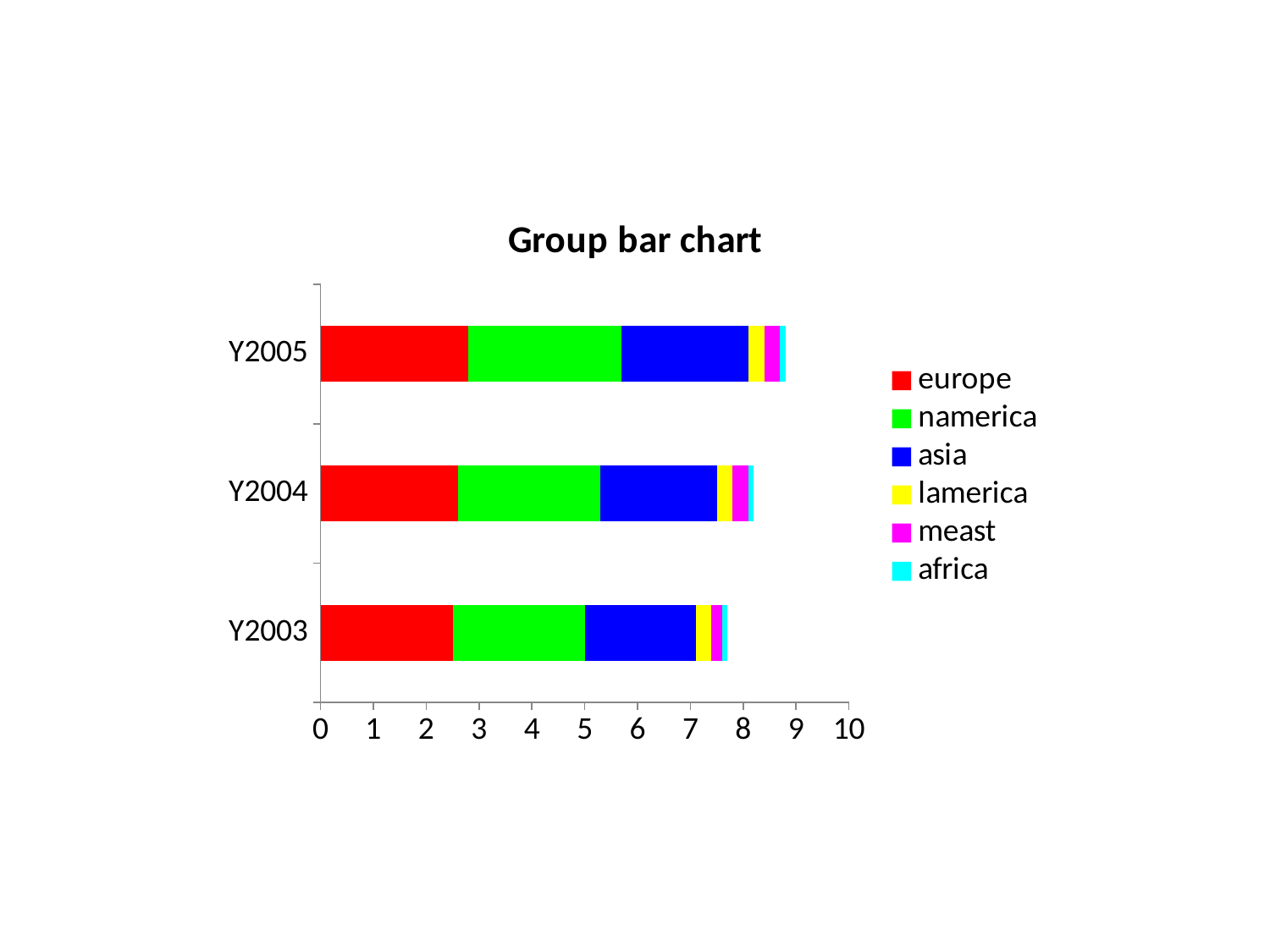
What kind of chart is shown on the slide? stacked bar chart Which year has the longest total bar? Y2005 Which total bar is longer, Y2004 or Y2003? Y2004 Is the europe value for Y2005 greater or less than 2? greater Is the total bar length for Y2005 greater or less than 8? greater How many categories (years) are plotted on the chart? 3 Do the total bar lengths rise or fall from Y2003 to Y2005? rise What is the title of the chart? Group bar chart Which year has the shortest total bar? Y2003 How many series does the legend list? 6 Which colour represents the asia series in the legend? blue Is the total bar length for Y2003 greater or less than 8? less